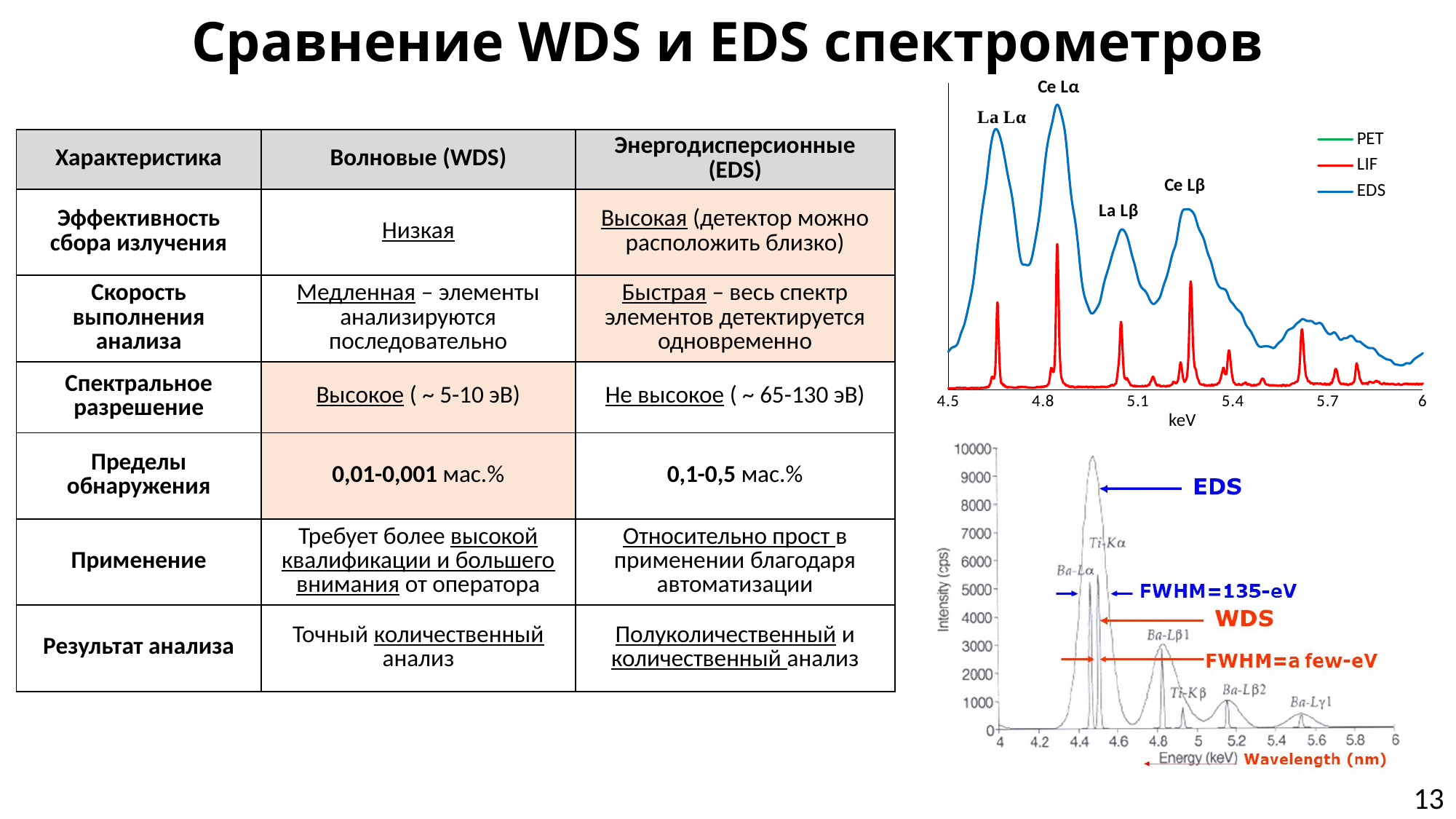
In the top-right chart, how many series does the legend list? 3 In the bottom-right chart, is the intensity of the Ti Kα EDS peak greater or less than 9000? greater In the bottom-right chart, which peak is higher: Ti Kα or Ba-Lβ1? Ti Kα In the top-right chart, what unit is shown on the x axis? keV In the top-right chart, how many peaks are labelled with element lines? 4 In the bottom-right chart, what FWHM value is given for EDS? 135-eV In the top-right chart, which labelled peak of the EDS curve is the highest? Ce Lα In the top-right chart, what are the series named in the legend? PET, LIF, EDS In the top-right chart, which is higher on the EDS curve: the La Lα peak or the La Lβ peak? La Lα In the bottom-right chart, what is the y axis label? Intensity (cps) What kind of chart is the top-right chart? line chart In the bottom-right chart, what FWHM value is given for WDS? a few-eV